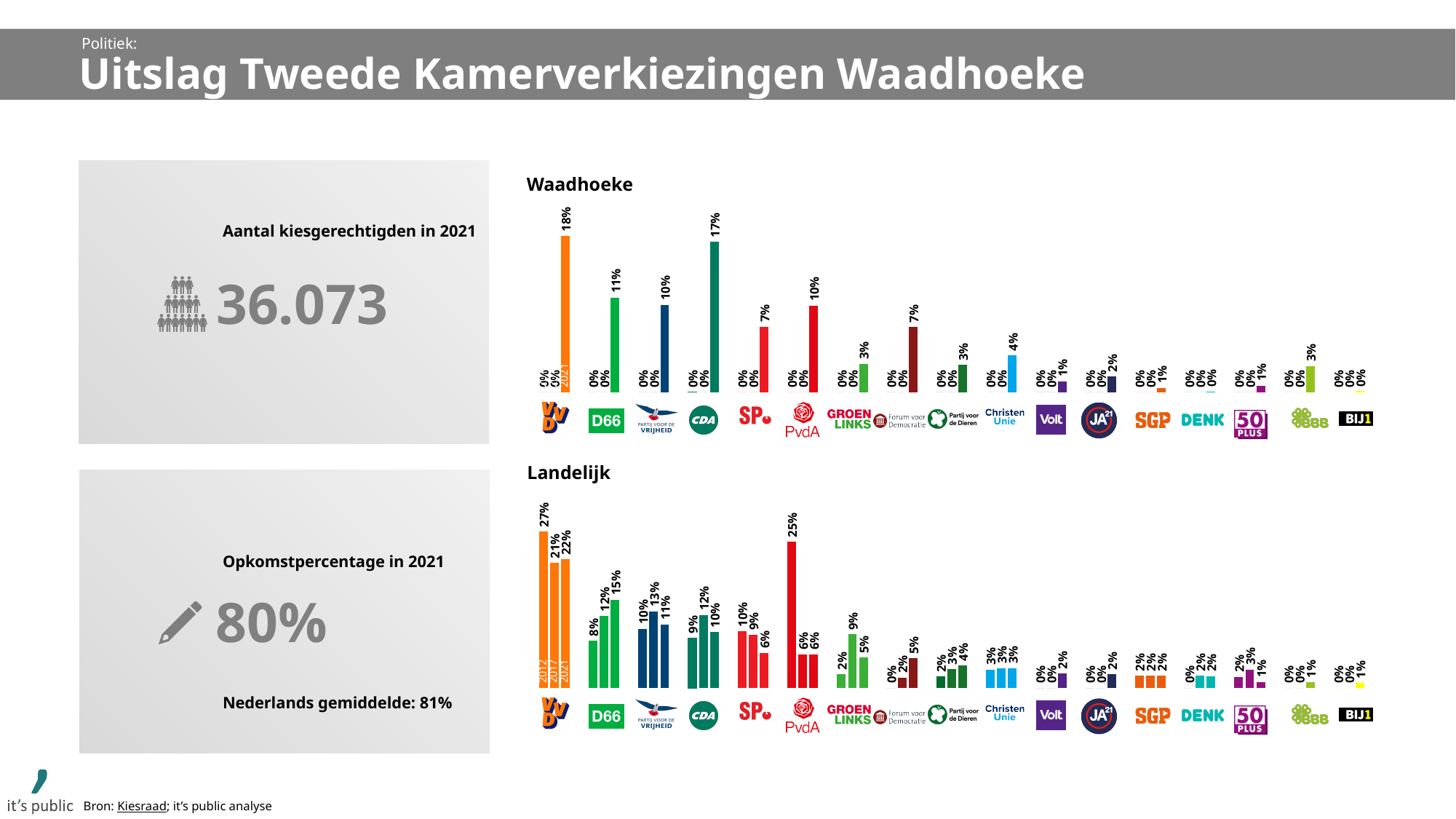
In the Waadhoeke chart, what is the difference between the 2021 percentages of the VVD and D66? 7% What kind of chart is the Landelijk chart? bar chart In the Landelijk chart, which party has the highest 2012 percentage? VVD In the Landelijk chart, what is the difference between the VVD's 2012 and 2021 percentages? 5% In the Landelijk chart, what percentage did D66 get in 2021? 15% In the Landelijk chart, which is larger: the 2021 percentage of the PVV or of the CDA? PVV In the Landelijk chart, what percentage did the PvdA get in 2012? 25% In the Waadhoeke chart, what percentage did the VVD get in 2021? 18% In the Waadhoeke chart, what percentage did the CDA get in 2021? 17% In the Waadhoeke chart, which party has the highest 2021 percentage? VVD In the Landelijk chart, do the D66 percentages rise or fall from 2012 to 2021? rise How many parties are shown in the Waadhoeke chart? 17